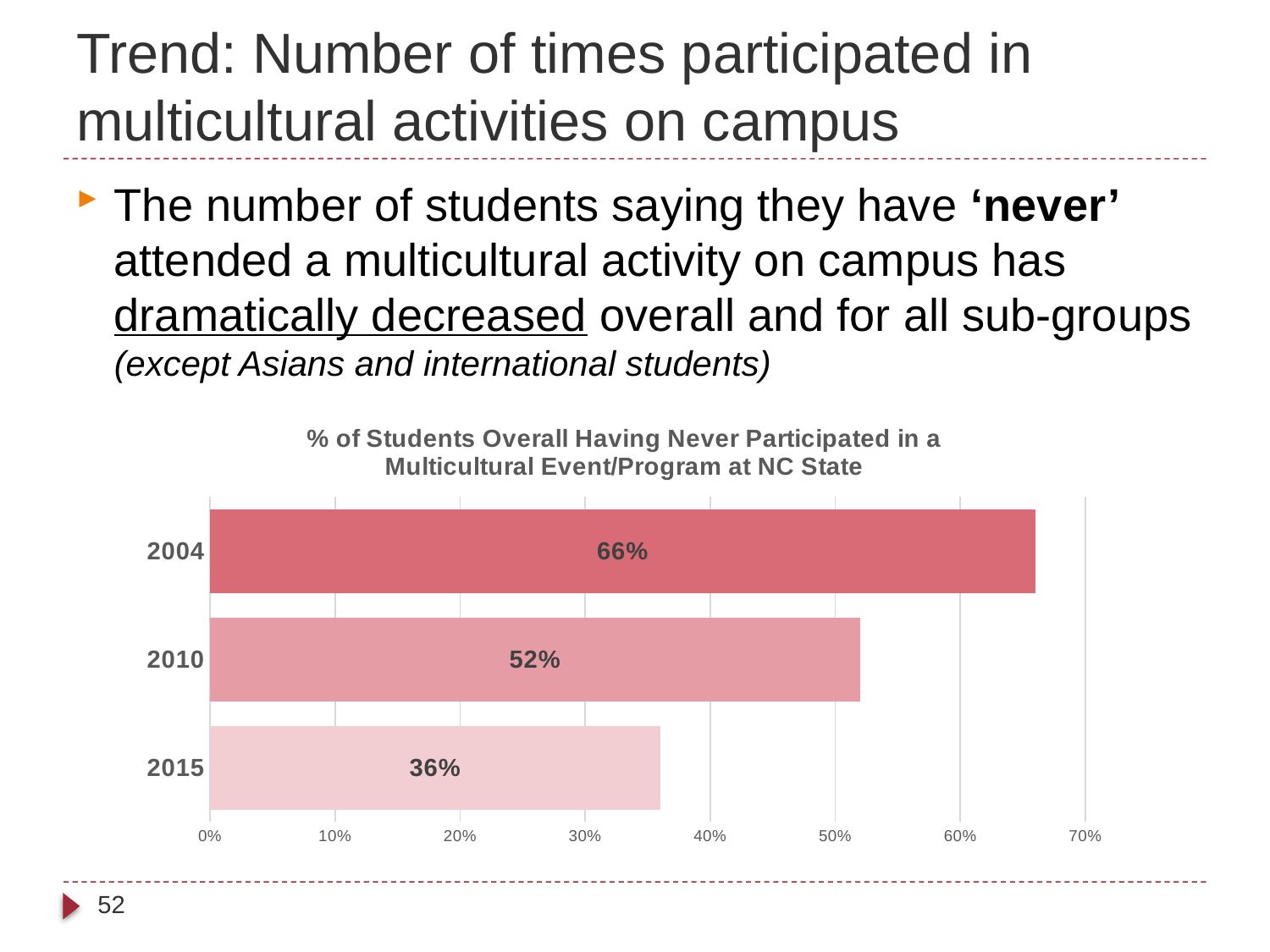
What is the value shown for 2010? 52% What is the difference between the 2004 and 2015 values? 30% How many years are shown in the chart? 3 Which year has the lowest percentage of students having never participated? 2015 Is the value for 2010 greater or less than 50%? greater What is the difference between the 2010 and 2015 values? 16% What is the title of the chart? % of Students Overall Having Never Participated in a Multicultural Event/Program at NC State Which year has the highest percentage of students having never participated? 2004 What is the value shown for 2015? 36% What kind of chart is shown on the slide? Bar chart What percentage of students had never participated in a multicultural event in 2004? 66% Which is larger, the value for 2010 or the value for 2015? 2010